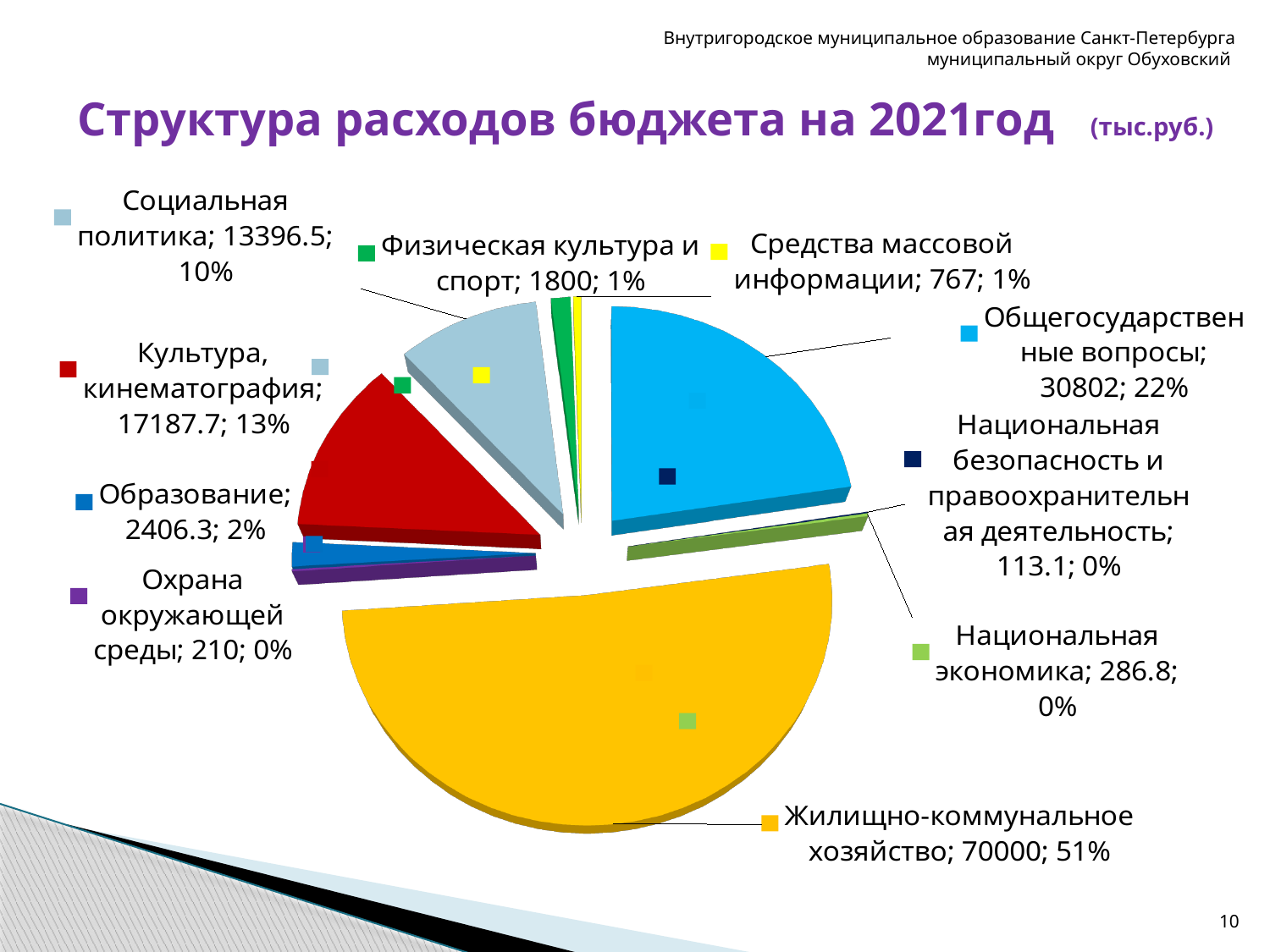
What is the difference between the values for Жилищно-коммунальное хозяйство and Общегосударственные вопросы? 39198 What kind of chart is shown on the slide? Pie chart What share of the pie does Общегосударственные вопросы represent? 22% What is the value for Образование? 2406.3 What is the value for Культура, кинематография? 17187.7 Which category has the largest share of the pie? Жилищно-коммунальное хозяйство Which category has the smallest value? Национальная безопасность и правоохранительная деятельность Which is larger, the value for Физическая культура и спорт or the value for Средства массовой информации? Физическая культура и спорт How many categories does the pie chart have? 10 What is the value for Жилищно-коммунальное хозяйство? 70000 What is the value for Общегосударственные вопросы? 30802 What share of the pie does Социальная политика represent? 10%